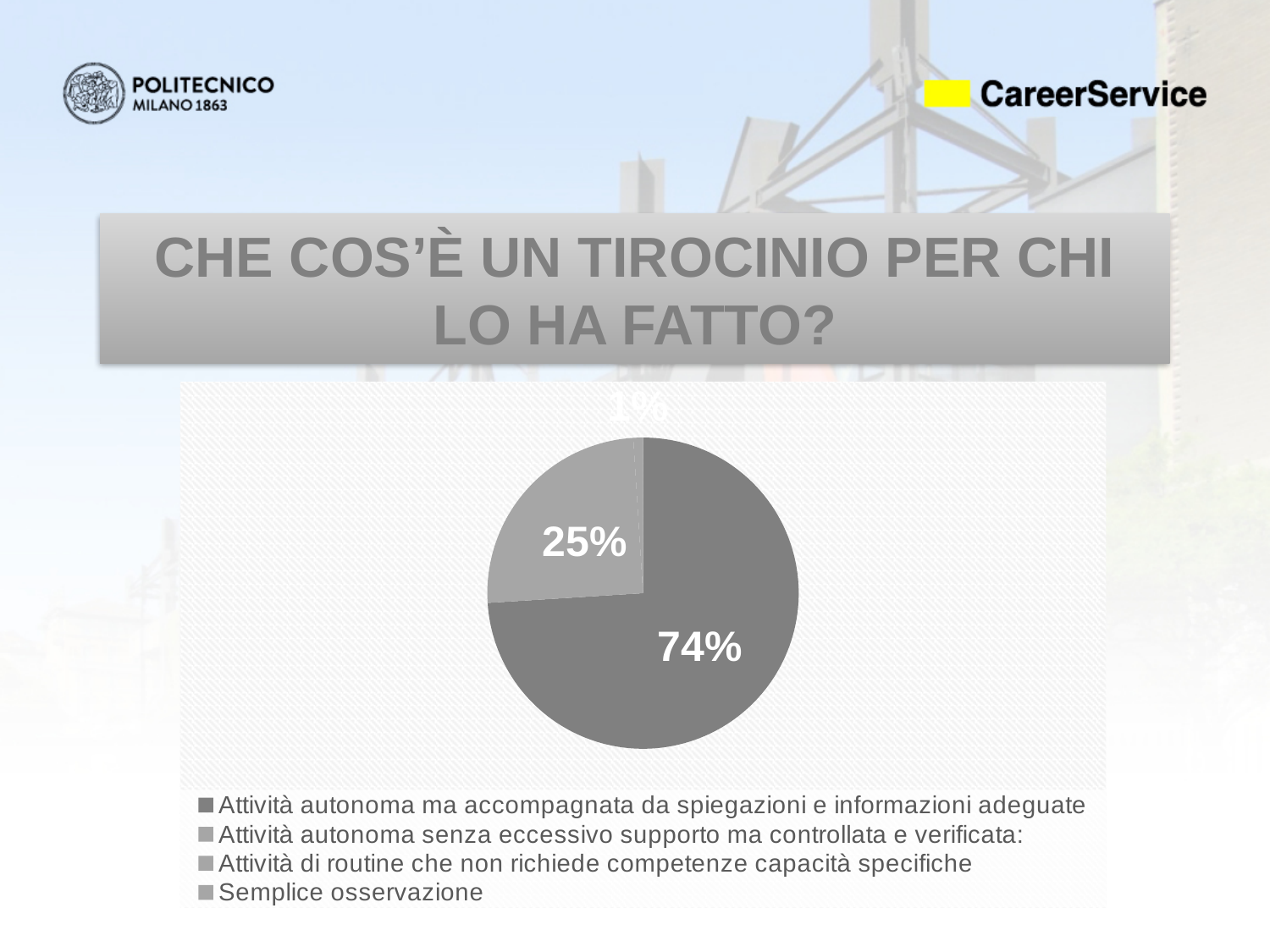
What is the title shown above the pie chart? CHE COS'È UN TIROCINIO PER CHI LO HA FATTO? What is the value of the second-largest slice in the pie chart? 25% What is the value of the smallest labelled slice in the pie chart? 1% What is the last entry listed in the legend of the pie chart? Semplice osservazione What is the difference between the 25% slice and the 1% slice? 24% What is the share of the pie taken by the darkest slice, corresponding to 'Attività autonoma ma accompagnata da spiegazioni e informazioni adeguate'? 74% How many percentage labels are printed on the pie chart? 3 How many entries does the legend of the pie chart list? 4 Which is larger, the slice labelled 25% or the slice labelled 74%? 74% What kind of chart is shown on the slide? pie chart What is the value of the largest slice in the pie chart? 74% What is the difference between the 74% slice and the 25% slice? 49%